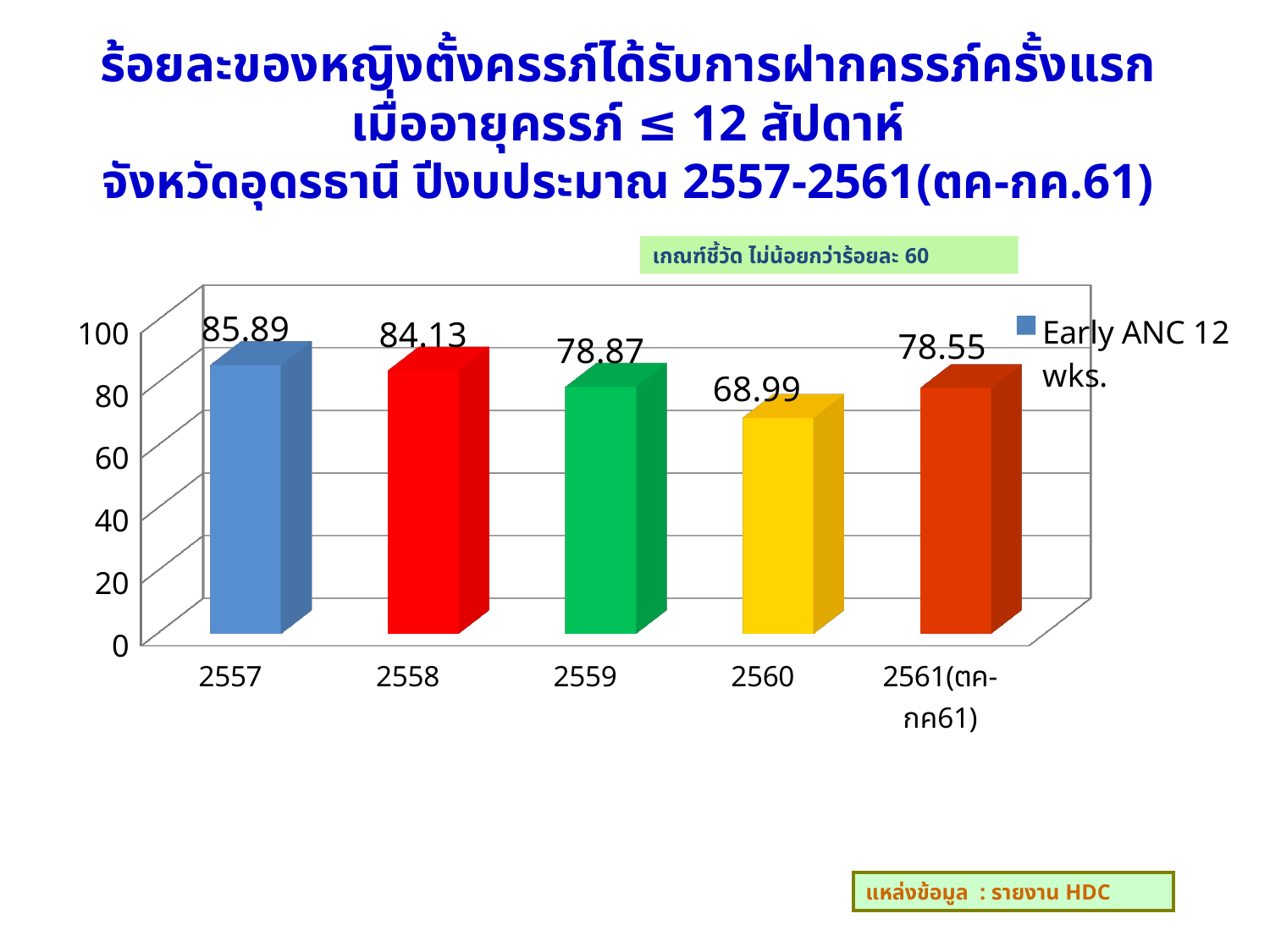
What is the value for 2561(ตค-กค61)? 78.55 What kind of chart is shown? bar chart How many years are shown on the x axis? 5 What is the value for 2557? 85.89 Which year has the highest value? 2557 Which is larger, the value for 2559 or the value for 2561(ตค-กค61)? 2559 Is the value for 2560 greater or less than 60? greater What is the difference between the values for 2559 and 2560? 9.88 What is the value for 2560? 68.99 What series name does the legend show? Early ANC 12 wks. Which year has the lowest value? 2560 What is the difference between the values for 2557 and 2558? 1.76